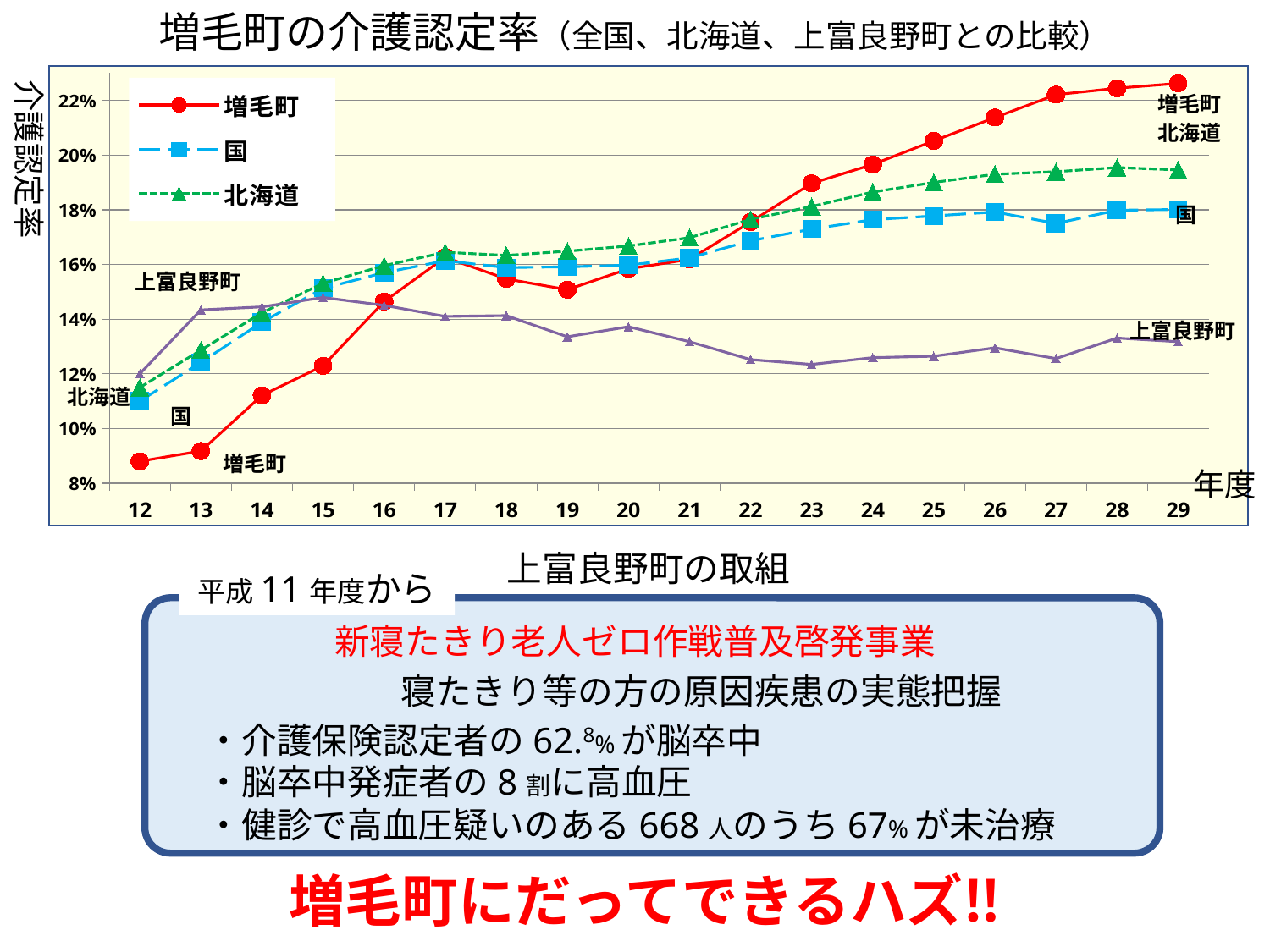
Which series has the highest value in year 29? 増毛町 How many years (x-axis points) are plotted on the chart? 18 In year 29, which is larger: the value for 増毛町 or the value for 国? 増毛町 How many series does the chart's legend list? 3 In year 12, which is larger: the value for 上富良野町 or the value for 増毛町? 上富良野町 Is the value for 上富良野町 in year 29 greater or less than 14%? less What kind of chart is shown on the slide? line chart Is the value for 増毛町 in year 12 greater or less than 10%? less Is the value for 増毛町 in year 29 greater or less than 22%? greater Which series has the lowest value in year 12? 増毛町 Does the value for 増毛町 rise or fall from year 12 to year 29? rise